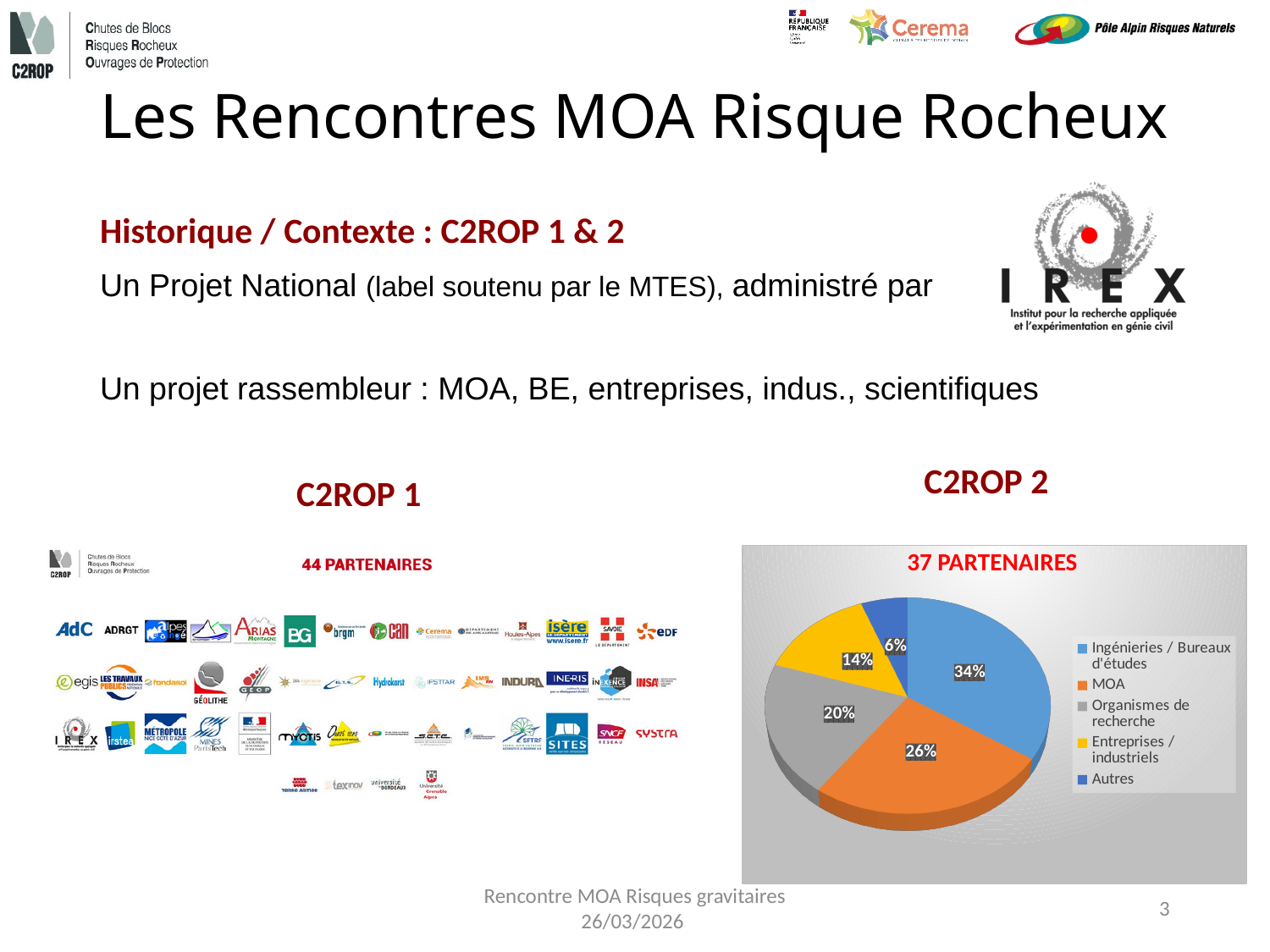
Which is larger, the share for Organismes de recherche or the share for Autres? Organismes de recherche What colour is the MOA slice in the pie chart? Orange Which category has the smallest slice of the pie? Autres What percentage is shown for Entreprises / industriels? 14% What percentage is shown for Organismes de recherche? 20% How many categories does the pie chart legend list? 5 What share of the pie does Ingénieries / Bureaux d'études represent? 34% What percentage is shown for MOA in the pie chart? 26% What kind of chart is shown under the C2ROP 2 heading? Pie chart What is the difference in percentage points between MOA and Entreprises / industriels? 12 Which category has the largest slice of the pie? Ingénieries / Bureaux d'études What is the title of the pie chart? 37 PARTENAIRES